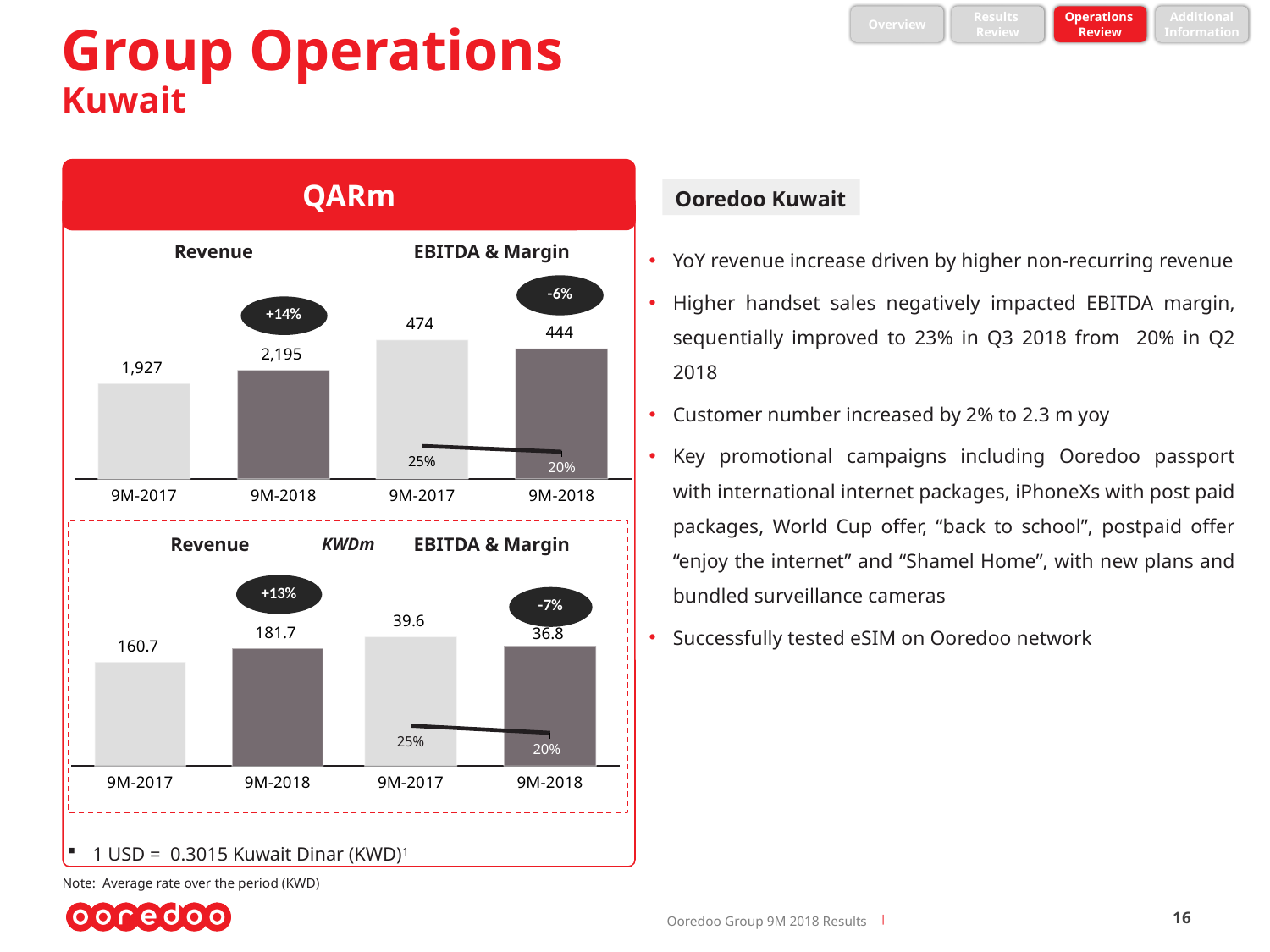
In the QARm EBITDA & Margin chart, which period has the higher EBITDA, 9M-2017 or 9M-2018? 9M-2017 In the QARm EBITDA & Margin chart, what is the EBITDA for 9M-2018? 444 In the QARm EBITDA & Margin chart, what is the EBITDA margin for 9M-2017? 25% In the KWDm EBITDA & Margin chart, does the EBITDA margin rise or fall from 9M-2017 to 9M-2018? Fall In the QARm Revenue chart, what is the revenue for 9M-2017? 1,927 In the KWDm Revenue chart, what is the revenue for 9M-2018? 181.7 In the KWDm EBITDA & Margin chart, what is the EBITDA for 9M-2017? 39.6 In the KWDm EBITDA & Margin chart, what is the difference in EBITDA between 9M-2017 and 9M-2018? 2.8 In the QARm Revenue chart, what is the revenue for 9M-2018? 2,195 What type of chart is used for the KWDm Revenue chart? Bar chart In the QARm Revenue chart, what is the difference in revenue between 9M-2018 and 9M-2017? 268 What percentage change is shown in the bubble above the QARm Revenue chart? +14%